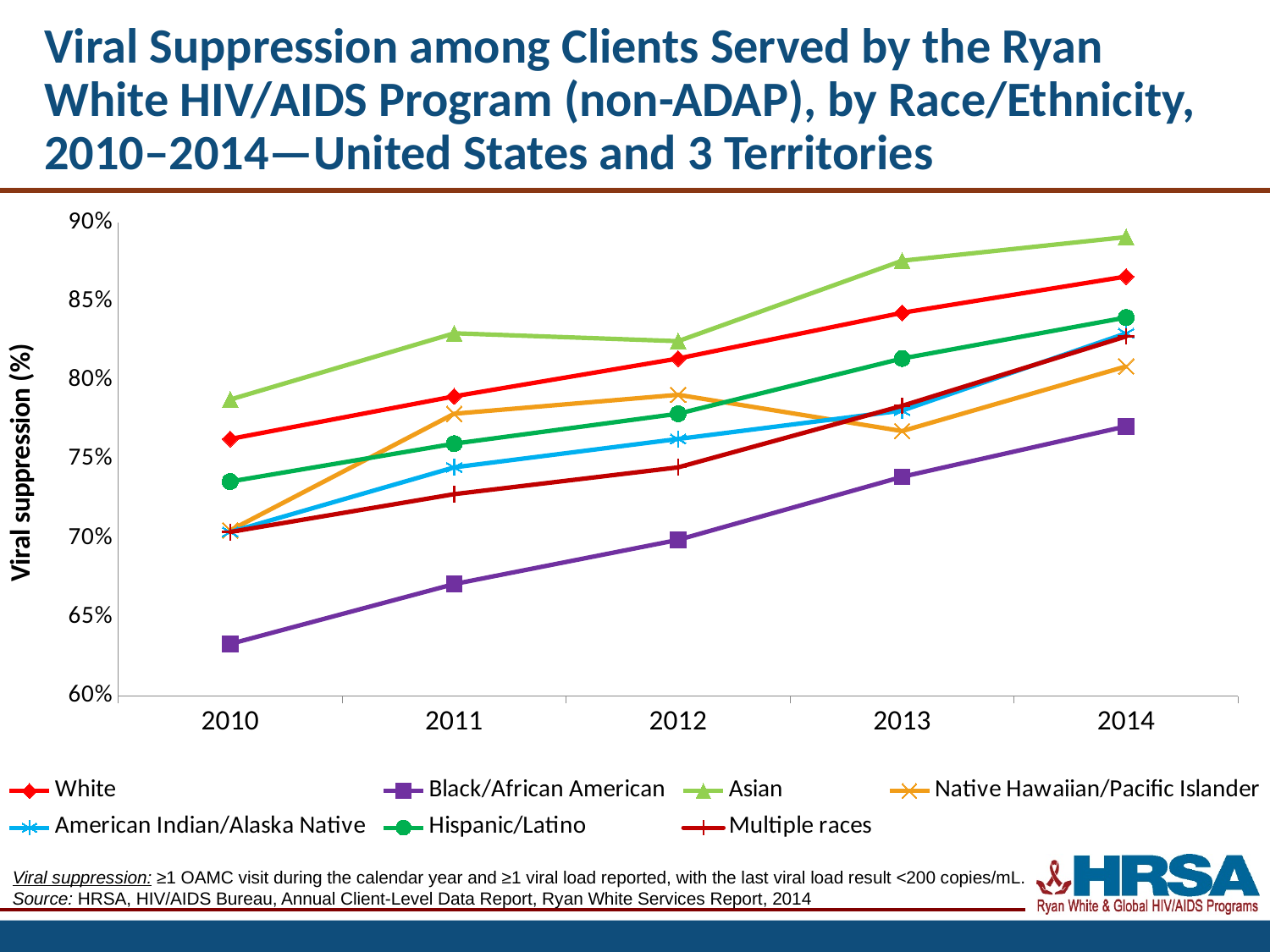
Does the viral suppression for Black/African American rise or fall from 2010 to 2014? rise In 2010, which is larger: the value for Asian or the value for White? Asian Is the value for Asian in 2014 greater or less than 85%? greater Is the value for Native Hawaiian/Pacific Islander in 2013 greater or less than 80%? less Is the value for Black/African American in 2010 greater or less than 65%? less How many years are plotted along the x axis? 5 Which race/ethnicity group has the highest viral suppression in 2014? Asian How many series does the legend list? 7 What kind of chart is shown on the slide? line chart In 2013, which is larger: the value for White or the value for Hispanic/Latino? White What is the title of the y axis? Viral suppression (%) Which race/ethnicity group has the lowest viral suppression in 2014? Black/African American